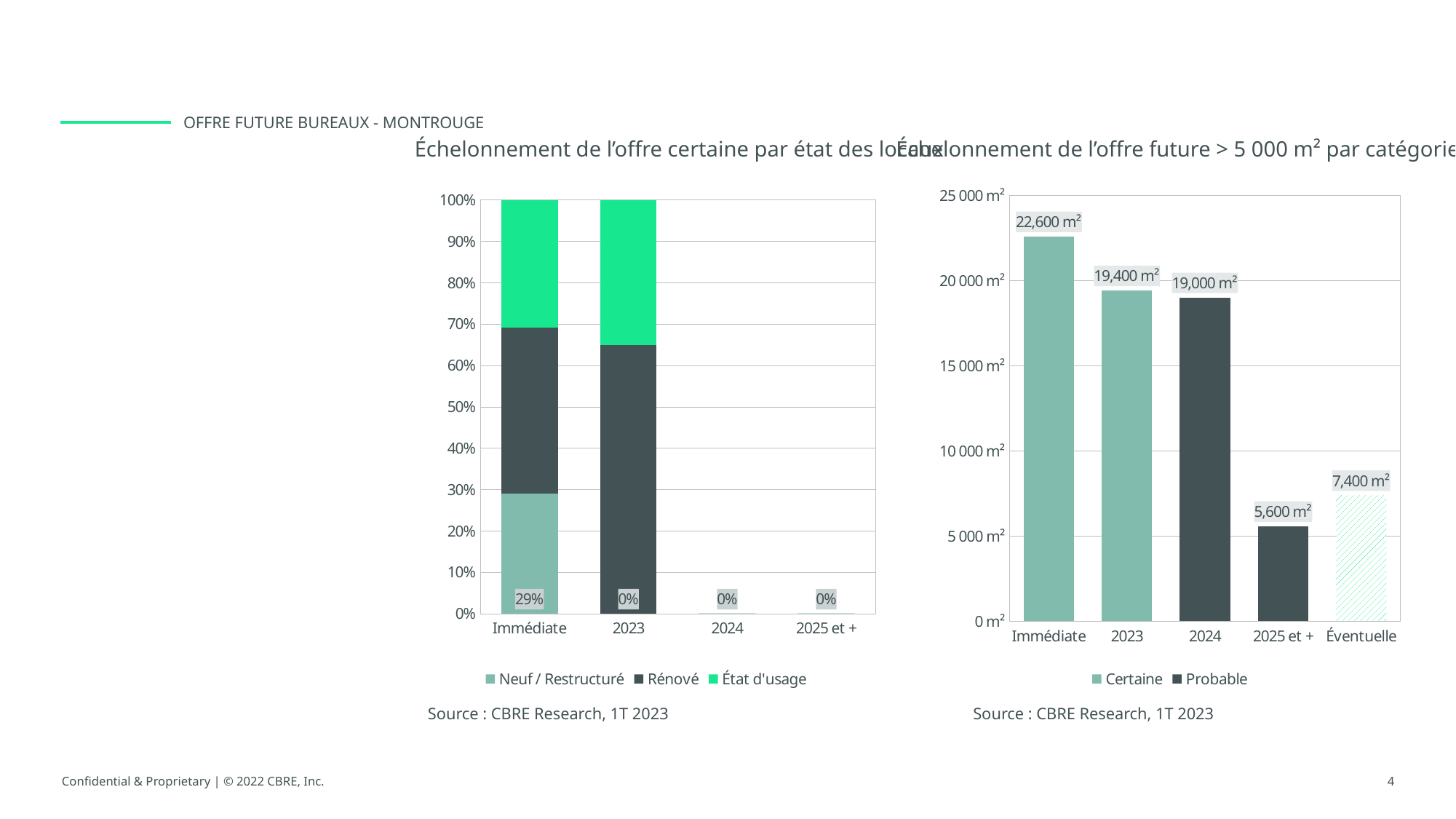
In the left-hand chart, what is the Neuf / Restructuré share for Immédiate? 29% In the right-hand chart, what is the value for 2025 et +? 5,600 m² In the right-hand chart, which is larger: the value for 2025 et + or the value for Éventuelle? Éventuelle How many series does the legend of the right-hand chart list? 2 In the right-hand chart, which category has the highest value? Immédiate In the left-hand chart, is the Rénové share for 2023 greater or less than 60%? greater How many categories are shown on the x axis of the right-hand chart? 5 In the right-hand chart, which category has the lowest value? 2025 et + How many series does the legend of the left-hand chart list? 3 In the right-hand chart, what is the value for Immédiate? 22,600 m² In the right-hand chart, what is the difference between the values for 2023 and 2024? 400 m² What kind of chart is the left-hand chart? Stacked bar chart